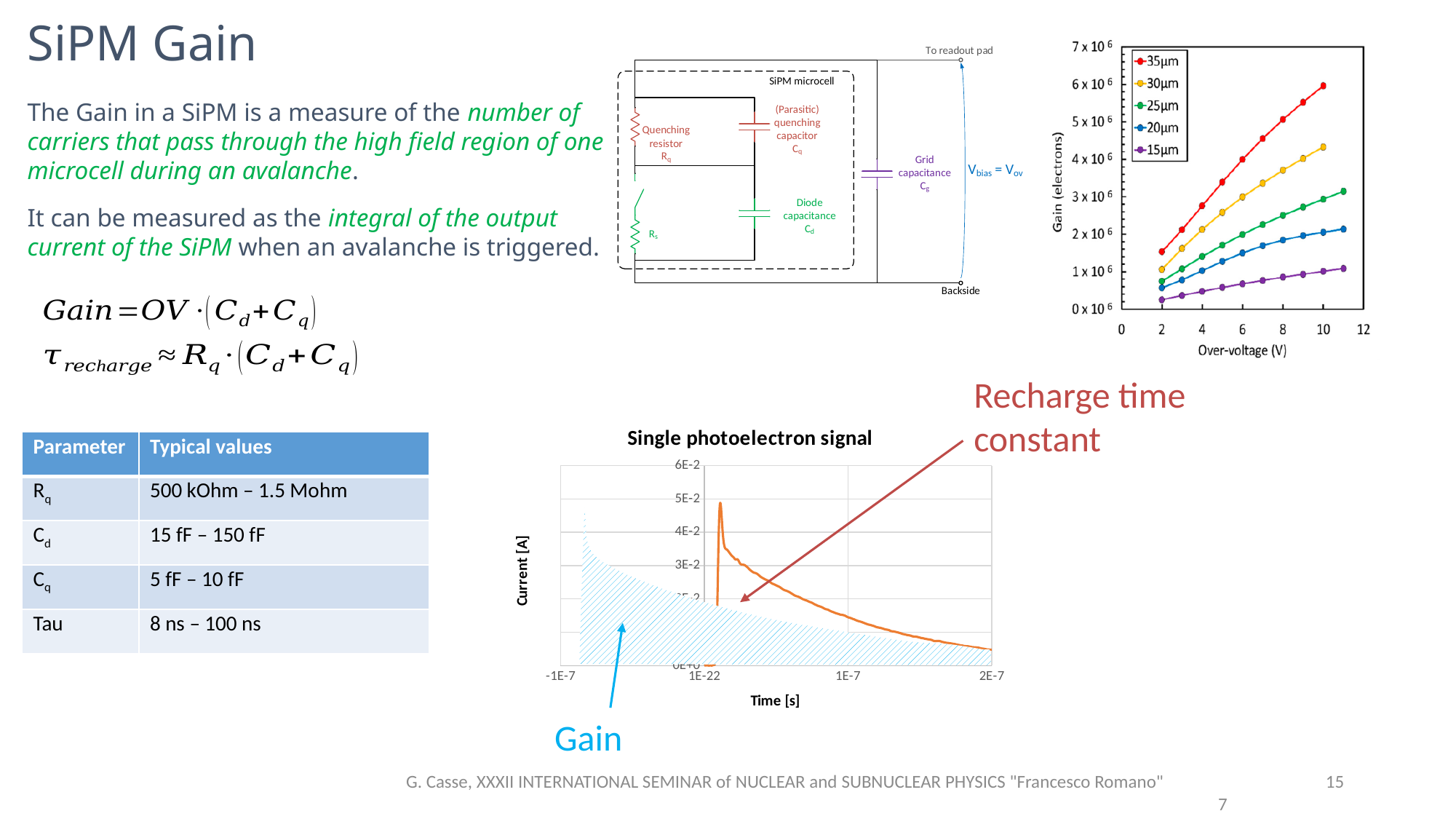
In the 'Single photoelectron signal' chart, is the peak current greater or less than 4E-2 A? greater In the 'Single photoelectron signal' chart, does the current rise or fall after the peak as time increases? fall What is the label of the x axis of the top-right gain chart? Over-voltage (V) In the top-right gain chart, is the gain of the 35µm series at 10 V over-voltage greater or less than 5 x 10^6 electrons? greater What is the title of the bottom chart? Single photoelectron signal In the top-right gain chart, does the gain rise or fall as over-voltage increases? rise In the top-right gain chart, which series has the highest gain at every over-voltage? 35µm What kind of chart is the top-right chart of gain versus over-voltage? line chart How many series does the legend of the top-right gain chart list? 5 In the top-right gain chart, at 6 V over-voltage, which series has the larger gain, 30µm or 25µm? 30µm In the top-right gain chart, is the gain of the 30µm series at 10 V over-voltage greater or less than 4 x 10^6 electrons? greater In the top-right gain chart, which series has the lowest gain? 15µm